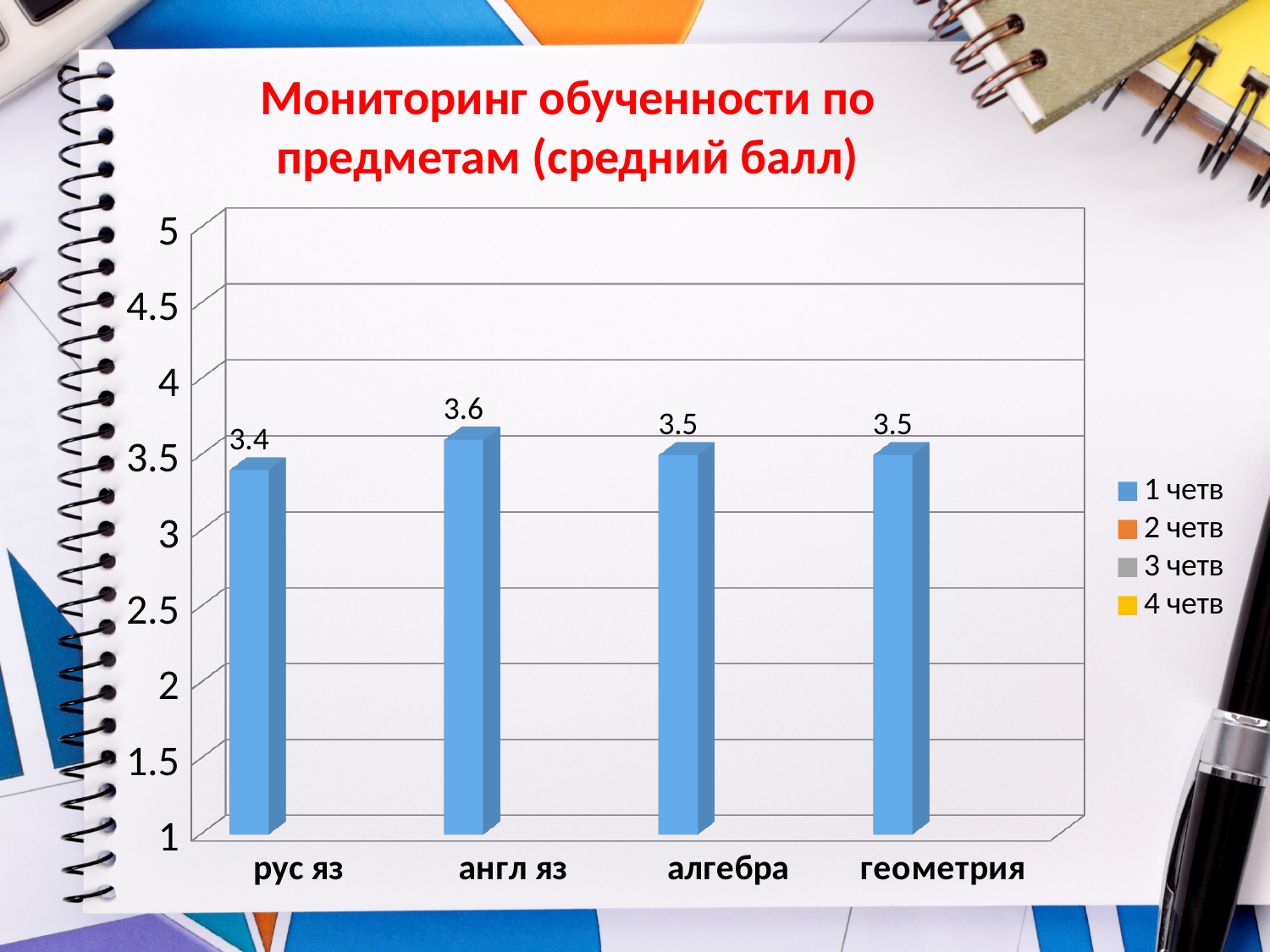
How many subjects are shown on the x axis? 4 What is the value for англ яз in the 1 четв series? 3.6 What is the value for алгебра in the 1 четв series? 3.5 Is the value for рус яз greater or less than 4? less What is the difference between the values for англ яз and рус яз? 0.2 Which is larger, the value for англ яз or the value for алгебра? англ яз What is the value for геометрия in the 1 четв series? 3.5 Which subject has the lowest value? рус яз Which subject has the highest value? англ яз How many series does the legend list? 4 What kind of chart is shown on the slide? bar chart What is the value for рус яз in the 1 четв series? 3.4